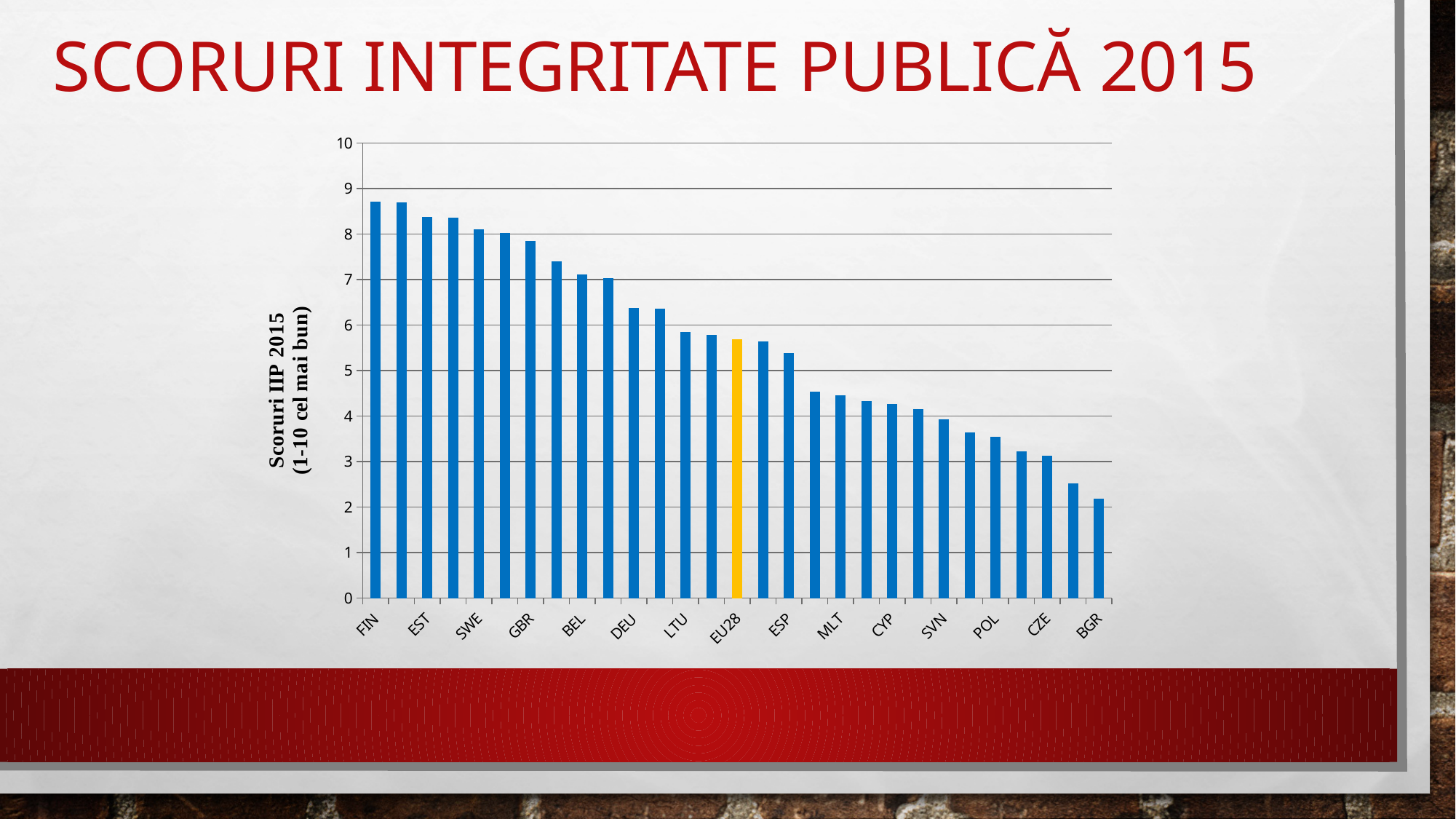
What kind of chart is shown on the slide? bar chart Is the value for FIN greater or less than 8? greater Do the bar values rise or fall from left to right along the x axis? fall Which has the larger value, DEU or ESP? DEU Which has the larger value, CYP or EU28? EU28 Which bar is highlighted in a different colour (yellow) from the others? EU28 Is the value for EU28 greater or less than 5? greater Is the value for MLT greater or less than 5? less Which labelled category has the lowest value? BGR